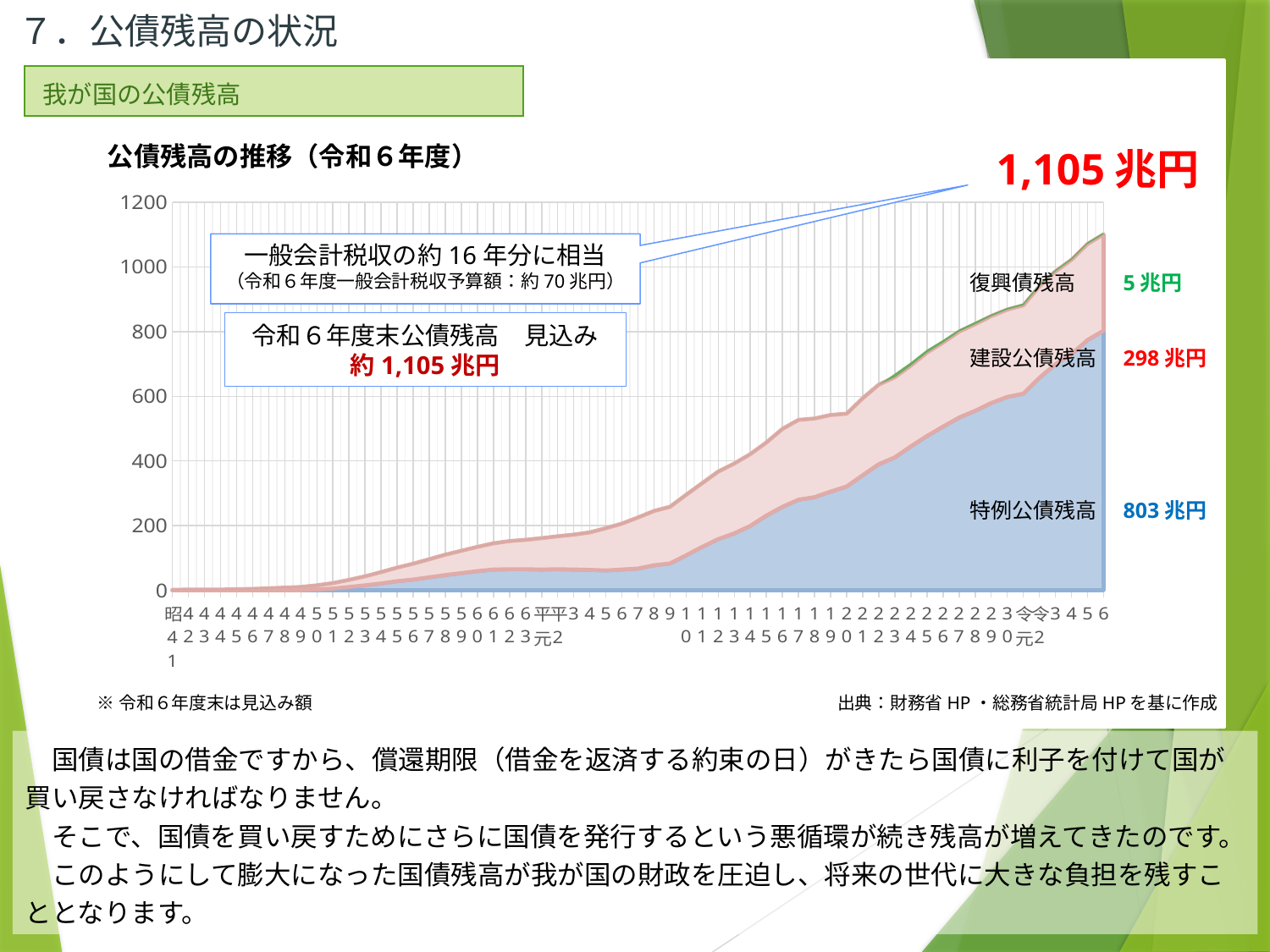
What is the value shown for 建設公債残高? 298兆円 What kind of chart is shown on the slide? Stacked area chart Which of the three bond categories has the smallest outstanding balance? 復興債残高 Does the total 公債残高 rise or fall over time along the x axis? Rise What is the total 公債残高 for 令和6年度末 shown on the slide? 1,105兆円 What is the value shown for 特例公債残高 at the end of the chart? 803兆円 Which is larger, 建設公債残高 or 特例公債残高? 特例公債残高 What is the difference between 特例公債残高 (803兆円) and 建設公債残高 (298兆円)? 505兆円 Is the total 公債残高 at 令和6 greater or less than 1000 on the axis? greater What is the value shown for 復興債残高? 5兆円 How many bond categories are labelled on the chart? 3 Which of the three bond categories has the largest outstanding balance? 特例公債残高